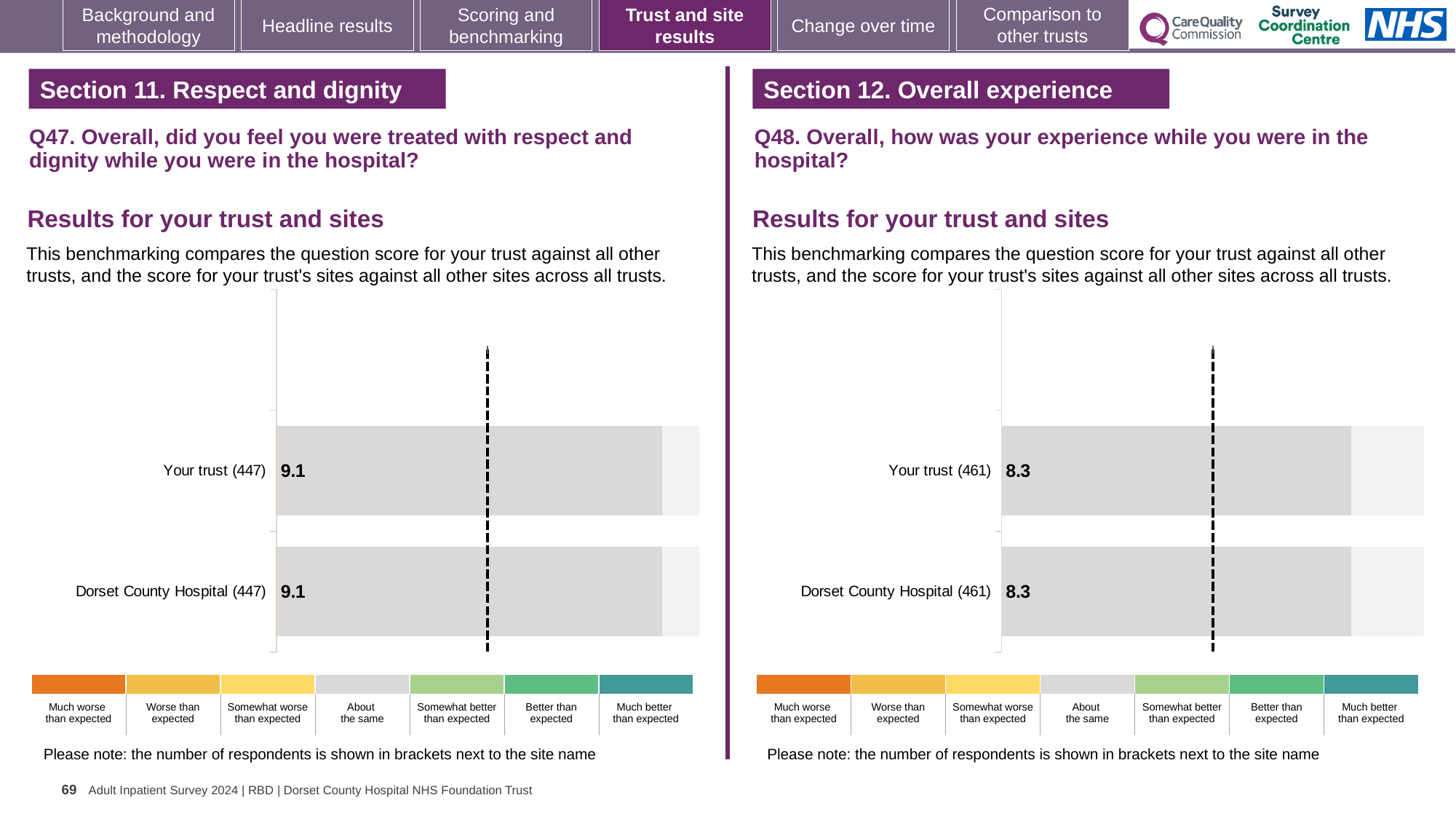
In the Q47 chart on the left, what is the score for Dorset County Hospital? 9.1 In the Q48 chart on the right, what is the score for Dorset County Hospital? 8.3 In the Q47 chart on the left, what is the score for Your trust? 9.1 In the Q47 chart on the left, how many respondents are shown in brackets next to Your trust? 447 What kind of chart is the Q47 chart on the left? Bar chart In the Q48 chart on the right, how many respondents are shown in brackets next to Dorset County Hospital? 461 How many bars are plotted in the Q47 chart on the left? 2 In the Q47 chart on the left, what is the difference between the score for Your trust and the score for Dorset County Hospital? 0.0 Is the score for Your trust in the Q47 chart on the left larger or smaller than the score for Your trust in the Q48 chart on the right? Larger In the Q48 chart on the right, what is the score for Your trust? 8.3 In the Q48 chart on the right, what is the difference between the score for Your trust and the score for Dorset County Hospital? 0.0 How many bars are plotted in the Q48 chart on the right? 2